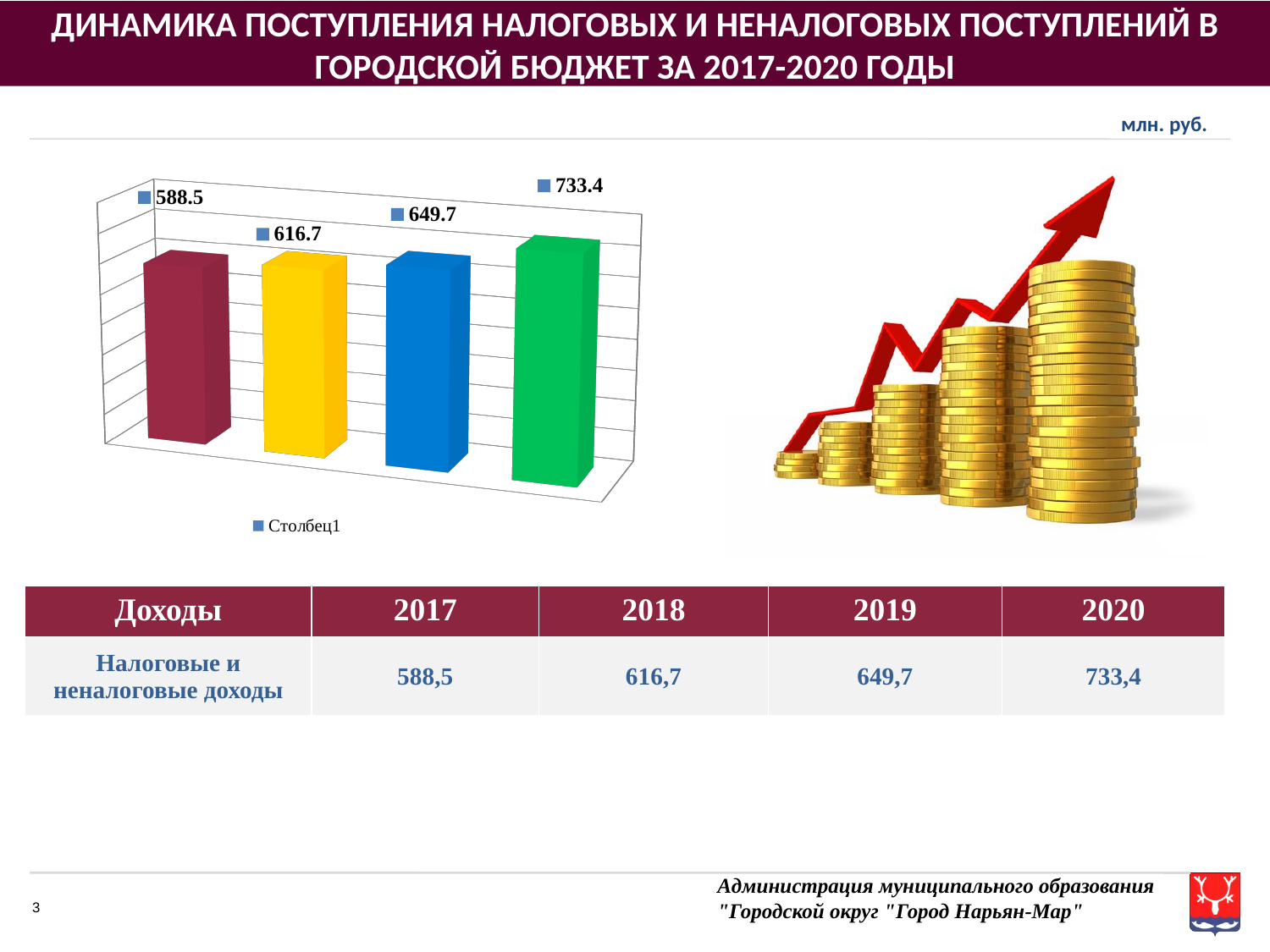
Which bar in the chart has the highest value? the fourth (green) bar, 733.4 How many bars are plotted in the chart? 4 What is the data label on the second (yellow) bar of the chart? 616.7 What is the data label on the fourth (green) bar of the chart? 733.4 What is the data label on the third (blue) bar of the chart? 649.7 Which bar in the chart has the lowest value? the first (dark red) bar, 588.5 What is the difference between the values of the fourth (green) bar and the first (dark red) bar? 144.9 Which is larger in the chart: the value of the blue bar or the value of the yellow bar? the blue bar (649.7) What is the data label on the first (leftmost, dark red) bar of the chart? 588.5 Do the bar values rise or fall from left to right across the chart? rise What entry does the chart's legend show? Столбец1 What type of chart is shown on the slide? bar chart